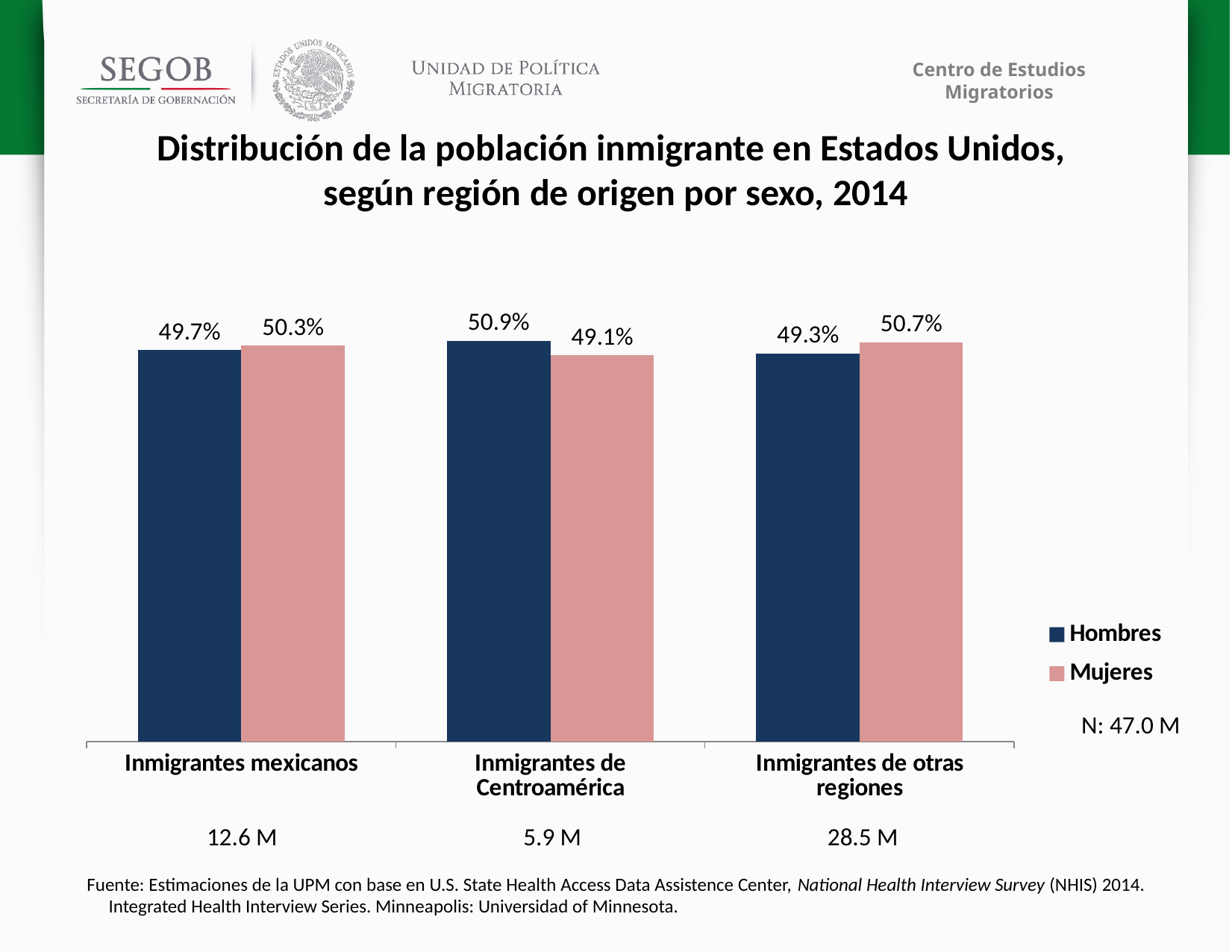
What kind of chart is shown on the slide? Bar chart What is the difference between the Mujeres and Hombres values for Inmigrantes de otras regiones? 1.4% What total N is shown next to the legend? N: 47.0 M Which category has the lowest value for Mujeres? Inmigrantes de Centroamérica What is the value for Hombres among Inmigrantes de otras regiones? 49.3% How many series does the legend list? 2 What is the value for Hombres among Inmigrantes mexicanos? 49.7% For Inmigrantes mexicanos, which is larger, the Hombres value or the Mujeres value? Mujeres How many categories are shown on the x axis? 3 Which category has the highest value for Hombres? Inmigrantes de Centroamérica What is the value for Mujeres among Inmigrantes de otras regiones? 50.7% What is the value for Mujeres among Inmigrantes de Centroamérica? 49.1%